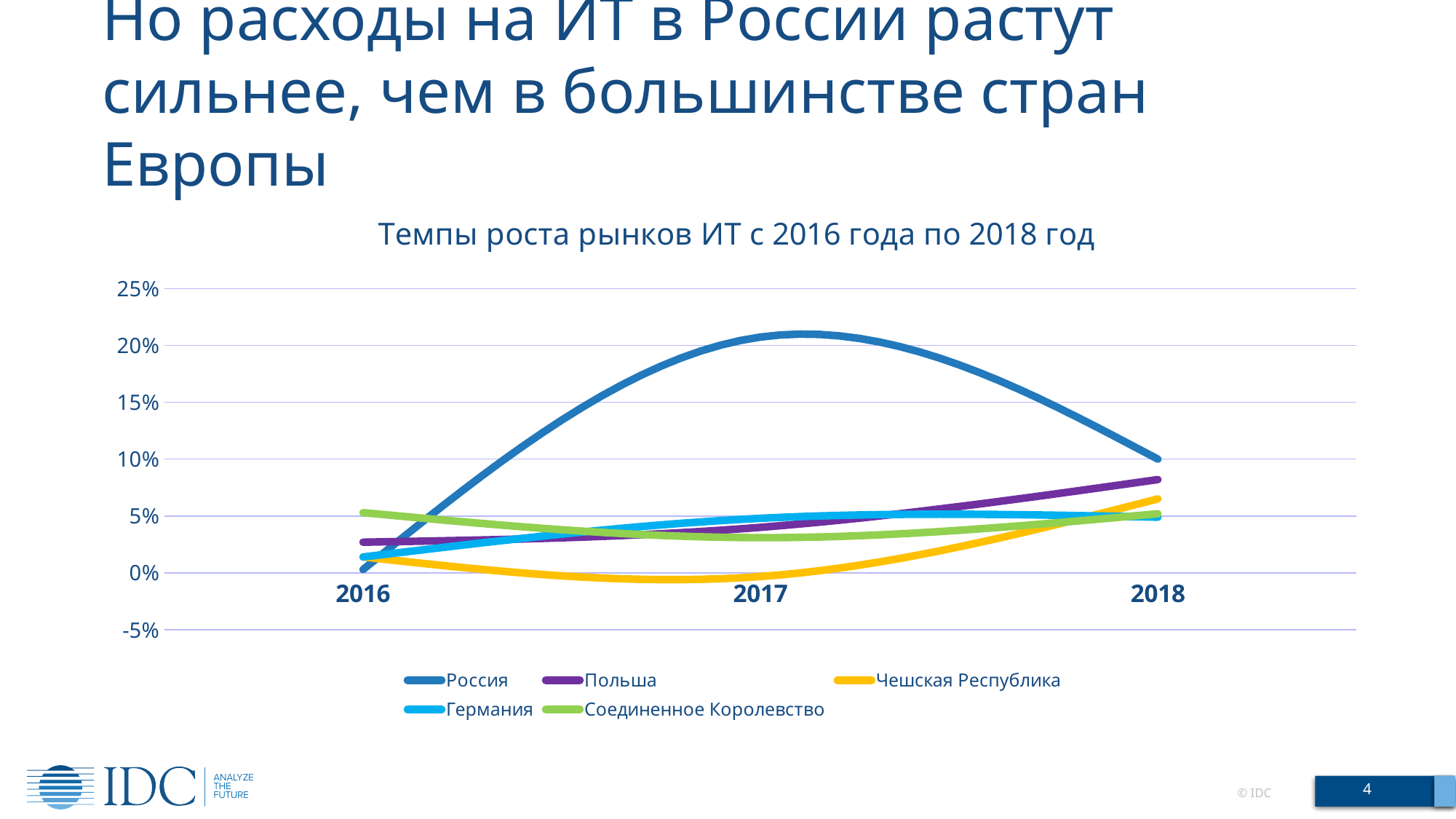
Does the line for Россия rise or fall from 2017 to 2018? fall Is the value for Россия in 2017 greater or less than 15%? greater How many years are shown on the x axis? 3 Which country has the highest growth rate in 2016? Соединенное Королевство Which country has the highest growth rate in 2017? Россия Which country has the lowest growth rate in 2017? Чешская Республика What kind of chart is shown on the slide? line chart Is the value for Россия in 2018 greater or less than 15%? less Is the value for Чешская Республика in 2017 greater or less than 5%? less How many series does the legend list? 5 What is the title of the chart? Темпы роста рынков ИТ с 2016 года по 2018 год In 2018, which is larger: the value for Польша or the value for Германия? Польша